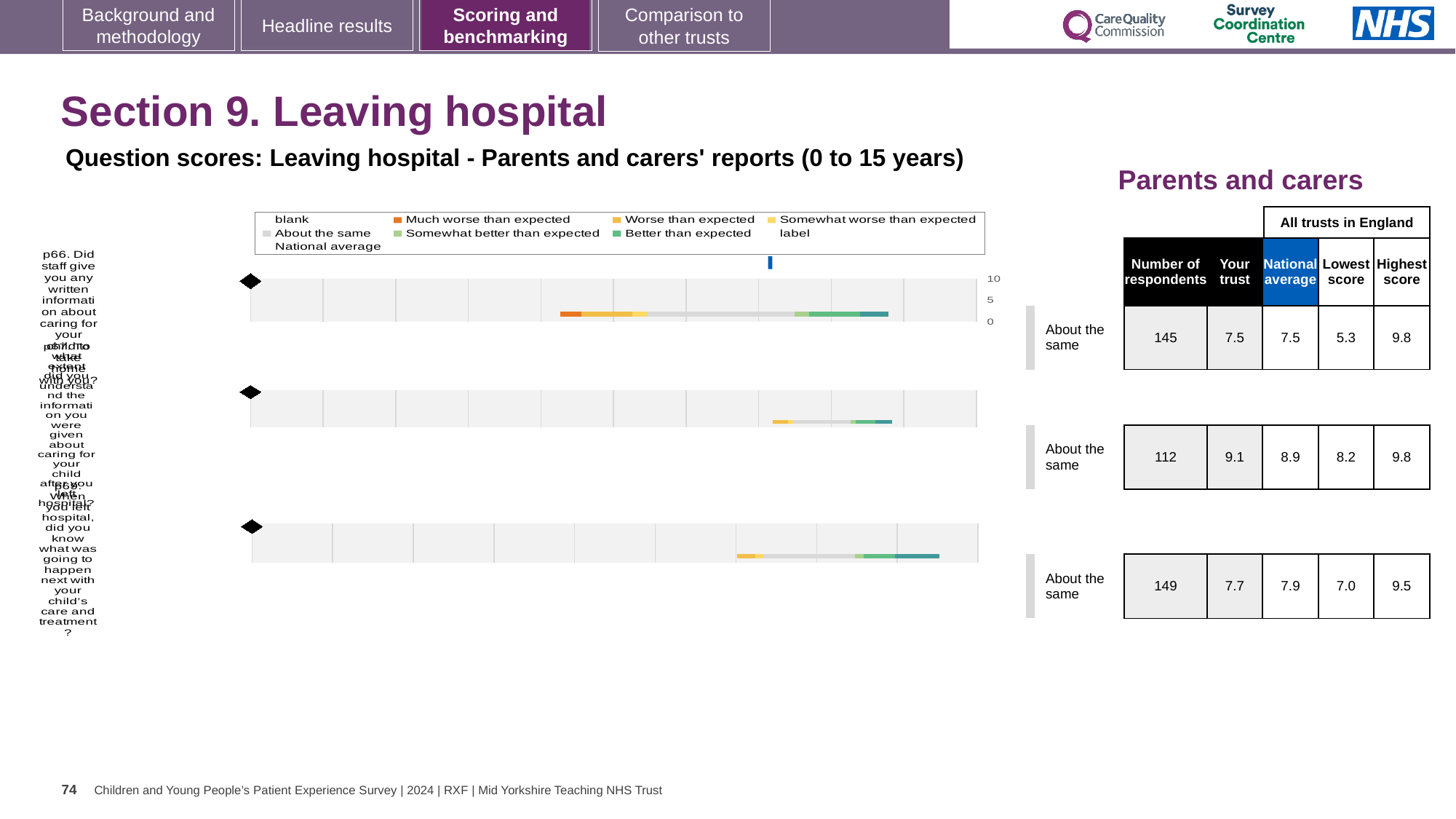
In the table, what is the number of respondents for the first row? 145 In the table, what is the highest score for the third row? 9.5 Which row in the table has the fewest respondents? the second row (112) In the table, what is the 'Your trust' score for the second row? 9.1 In the chart legend, what colour represents 'Much worse than expected'? orange What is the maximum value shown on the chart's score axis? 10 In the table, what is the national average for the third row? 7.9 In the table, what is the lowest score for the first row? 5.3 How many horizontal bars are plotted in the chart? 3 What kind of chart is shown on the slide? bar chart Which row in the table has the highest 'Your trust' score? the second row (9.1) What is the difference between the 'Your trust' score and the national average in the second row of the table? 0.2